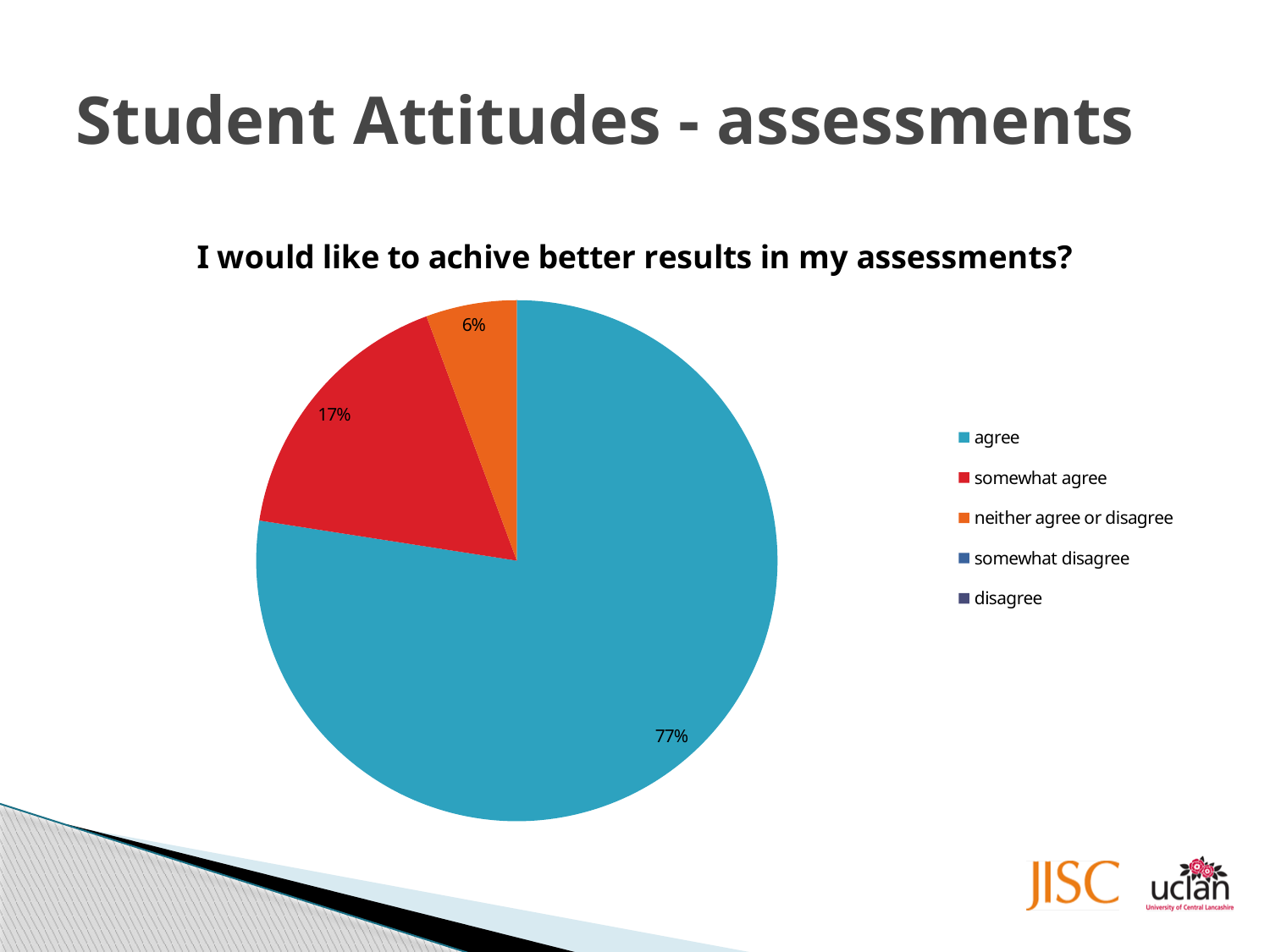
Which of the labelled slices has the smallest share? neither agree or disagree What percentage of students chose "agree"? 77% What percentage of students chose "neither agree or disagree"? 6% What kind of chart is shown on the slide? pie chart What is the difference in percentage points between "agree" and "somewhat agree"? 60 What percentage of students chose "somewhat agree"? 17% What colour is the "agree" slice? blue How many entries does the legend list? 5 Which is larger, the share for "somewhat agree" or the share for "neither agree or disagree"? somewhat agree What is the combined share of "agree" and "somewhat agree"? 94% Which response has the largest share of the pie? agree What is the title of the chart? I would like to achive better results in my assessments?